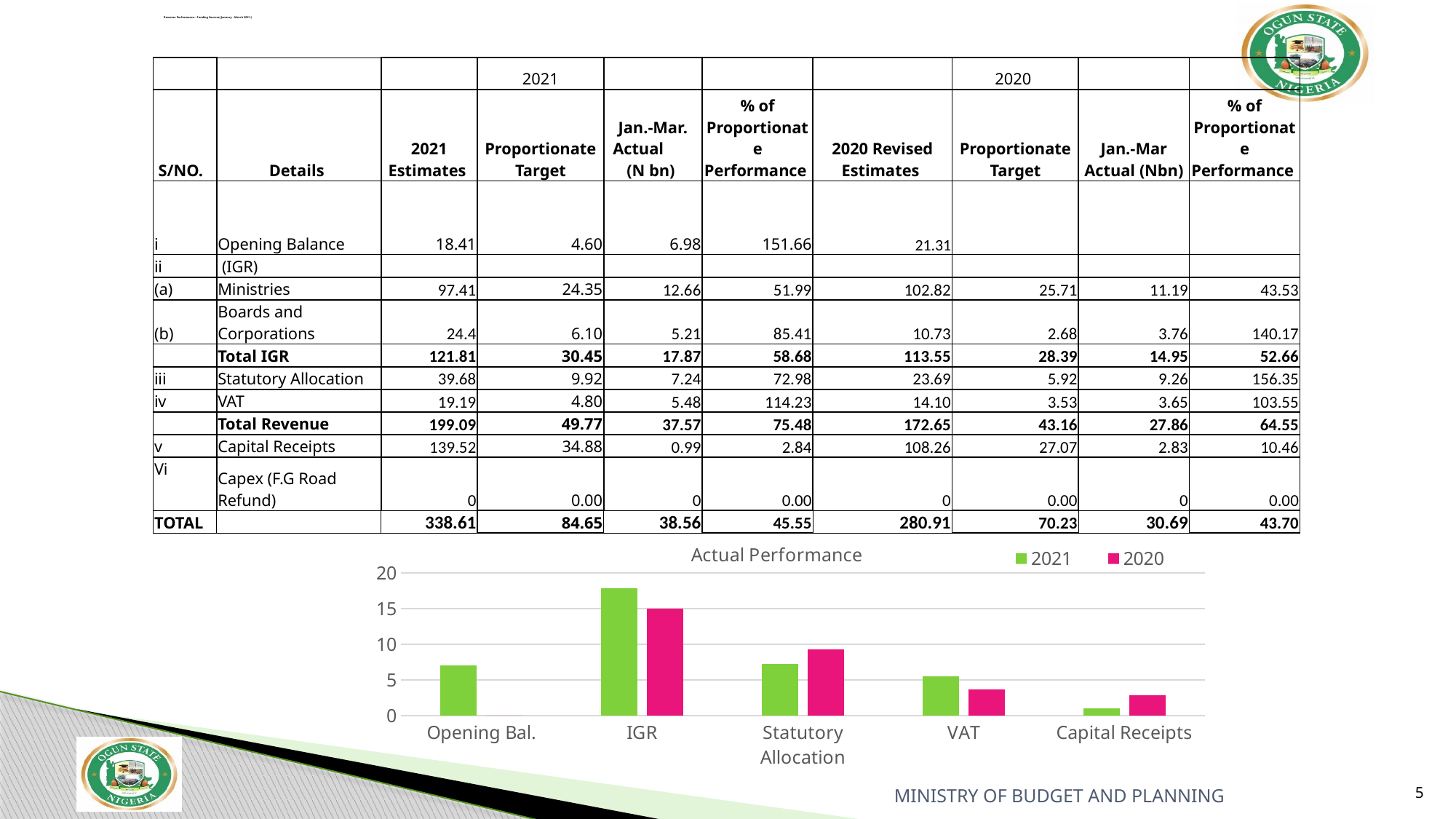
In the "Actual Performance" chart, is the 2021 value for Opening Bal. greater or less than 5? greater In the "Actual Performance" chart, which category has the highest 2020 value? IGR In the "Actual Performance" chart, which category has the highest 2021 value? IGR In the "Actual Performance" chart, which category has the lowest 2021 value? Capital Receipts In the "Actual Performance" chart, which category has no 2020 bar? Opening Bal. What type of chart is the "Actual Performance" chart? bar chart How many series does the legend of the "Actual Performance" chart list? 2 In the "Actual Performance" chart, for VAT, which series has the larger value, 2021 or 2020? 2021 How many categories are shown on the x axis of the "Actual Performance" chart? 5 In the "Actual Performance" chart, for Statutory Allocation, which series has the larger value, 2021 or 2020? 2020 In the "Actual Performance" chart, is the 2020 value for Statutory Allocation greater or less than 10? less In the "Actual Performance" chart, is the 2021 value for IGR greater or less than 15? greater